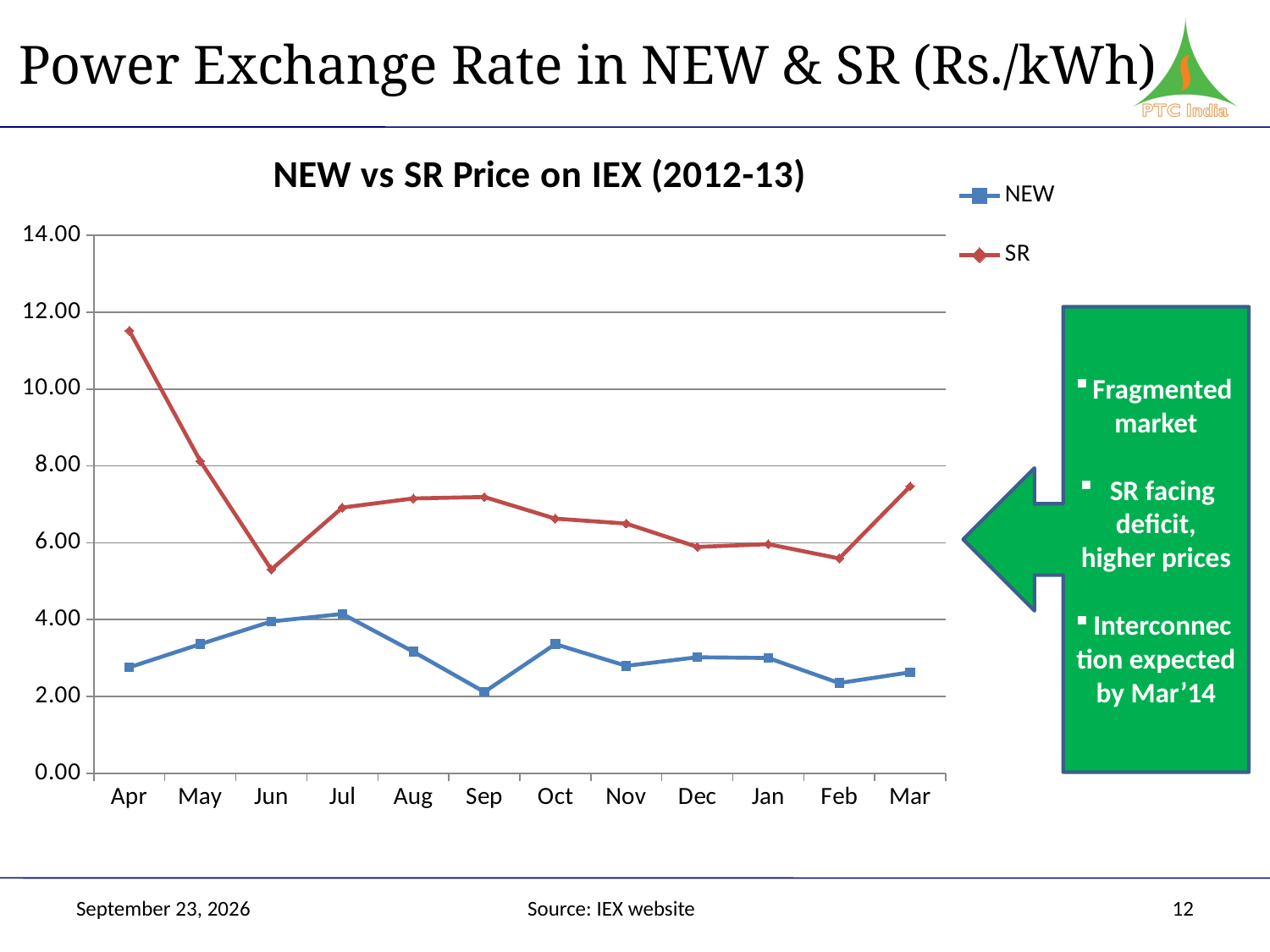
How many series does the legend list? 2 Does the SR price rise or fall from Apr to Jun? Fall What kind of chart is shown on the slide? Line chart What is the title of the chart? NEW vs SR Price on IEX (2012-13) In which month is the SR price highest? Apr Is the NEW value for Apr greater or less than 4.00? less In which month is the SR price lowest? Jun Is the SR value for Jun greater or less than 6.00? less Is the SR value for Apr greater or less than 10.00? greater Which series has the larger value in Apr, NEW or SR? SR How many months are plotted along the x axis? 12